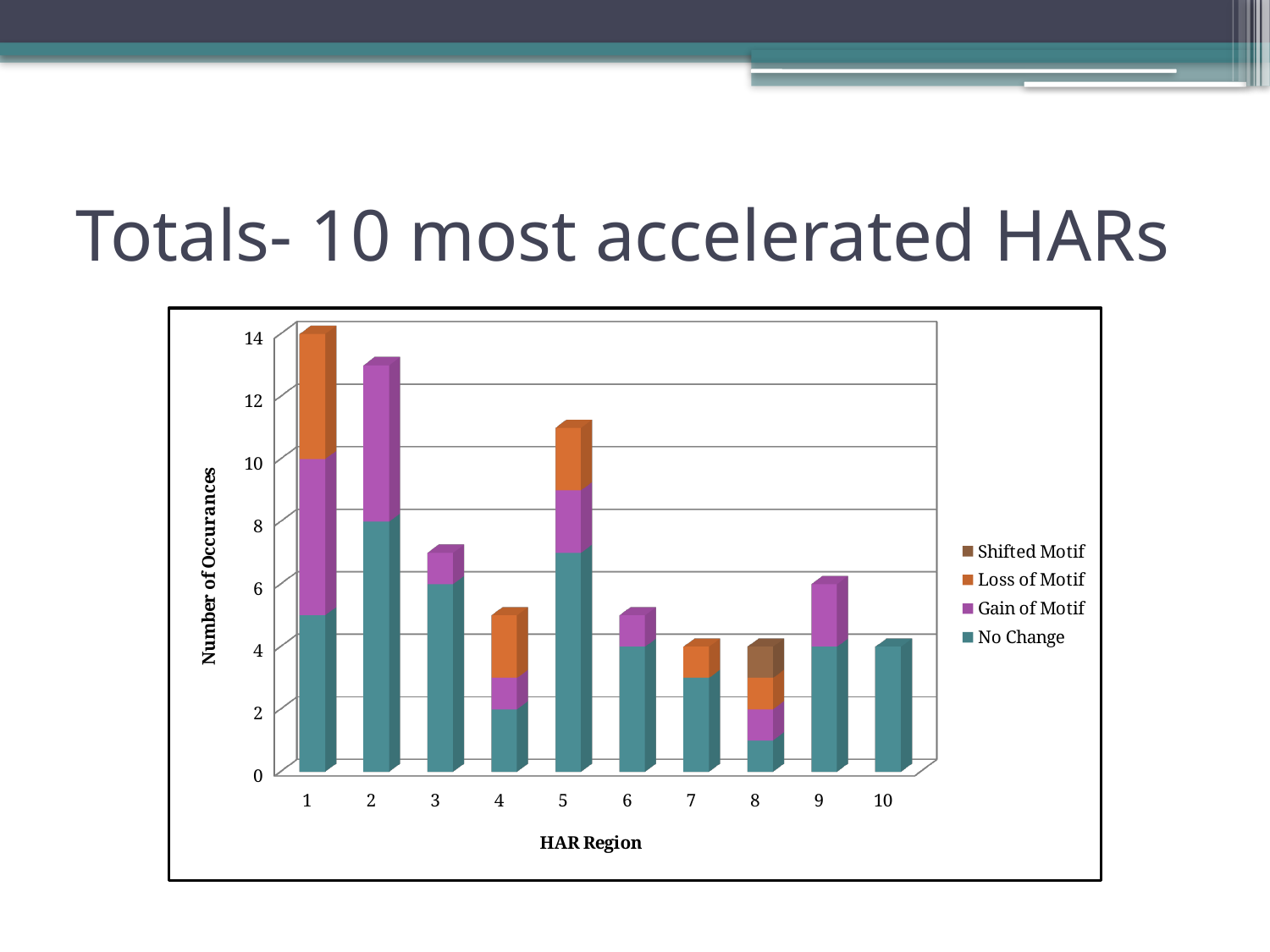
What is the value of No Change for HAR region 10? 4 Is the total for HAR region 2 greater or less than 12? greater What is the value of No Change for HAR region 2? 8 What is the total height of the stacked bar for HAR region 9? 6 How many HAR regions are shown on the x axis of the chart? 10 Which HAR region has the tallest stacked bar in the chart? 1 What kind of chart is shown on the slide? Stacked bar chart How many series does the chart's legend list? 4 Which stacked bar is taller, HAR region 1 or HAR region 5? HAR region 1 Is the total for HAR region 5 greater or less than 10? greater What is the title of the y axis of the chart? Number of Occurances What is the total height of the stacked bar for HAR region 1? 14